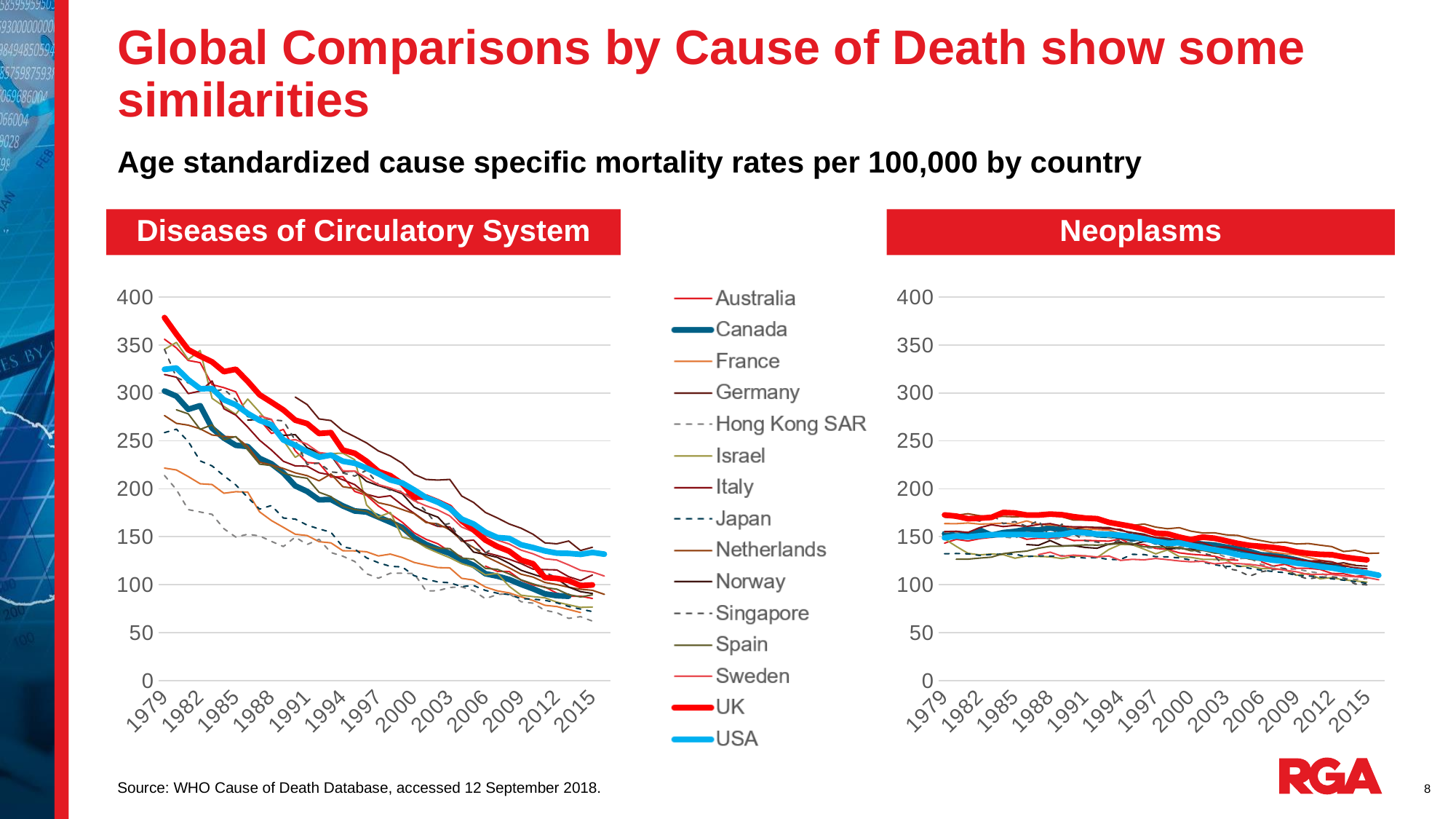
Which series in the legend is drawn with a light blue line? USA In the Diseases of Circulatory System chart, which series has the highest value in 1979? UK In the Diseases of Circulatory System chart, which is larger in 1979, the value for the UK or the value for the USA? UK In the Diseases of Circulatory System chart, is the value for the USA in 2015 greater or less than 150? less How many series does the shared legend list? 15 What kind of chart is the Diseases of Circulatory System chart? line chart In the Diseases of Circulatory System chart, is the value for the UK in 1979 greater or less than 350? greater In the Neoplasms chart, is the value for the USA in 2015 greater or less than 150? less In the Neoplasms chart, do the values for the USA rise or fall from 1979 to 2015? fall In the Diseases of Circulatory System chart, do the values for the UK rise or fall from 1979 to 2015? fall What is the title of the chart on the right of the slide? Neoplasms